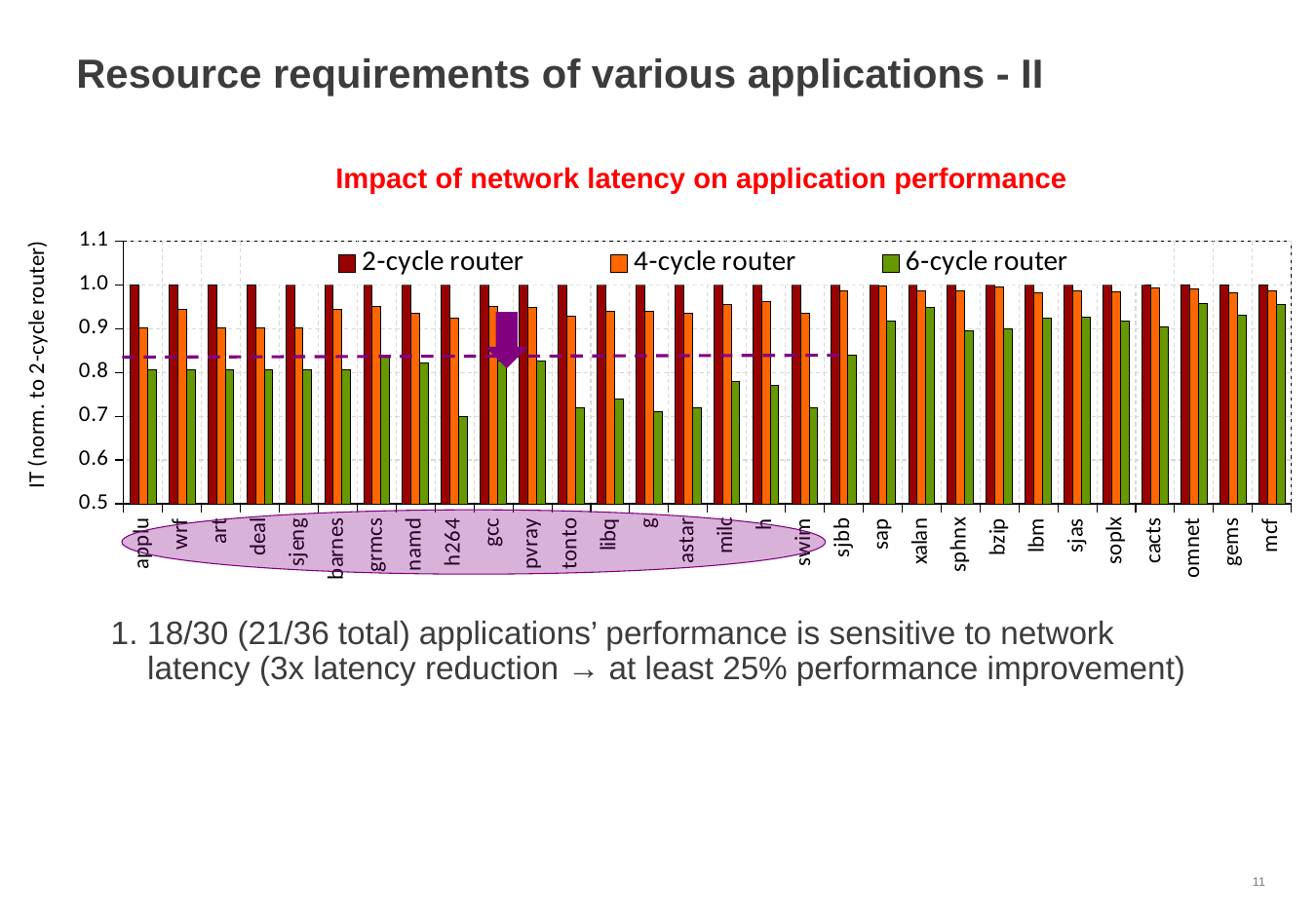
Is the 6-cycle router value for h264 greater or less than 0.8? less What is the title of the chart? Impact of network latency on application performance How many series does the legend list? 3 What is the value of the 2-cycle router bar for applu? 1.0 Is the 4-cycle router value for wrf greater or less than 0.9? greater What kind of chart is shown on the slide? bar chart How many applications (categories) are plotted along the x axis? 30 Is the 6-cycle router value for libq greater or less than 0.8? less Which is larger for tonto: the 4-cycle router value or the 6-cycle router value? 4-cycle router Which is larger: the 6-cycle router value for h264 or the 6-cycle router value for mcf? mcf What is the label of the y axis? IT (norm. to 2-cycle router)